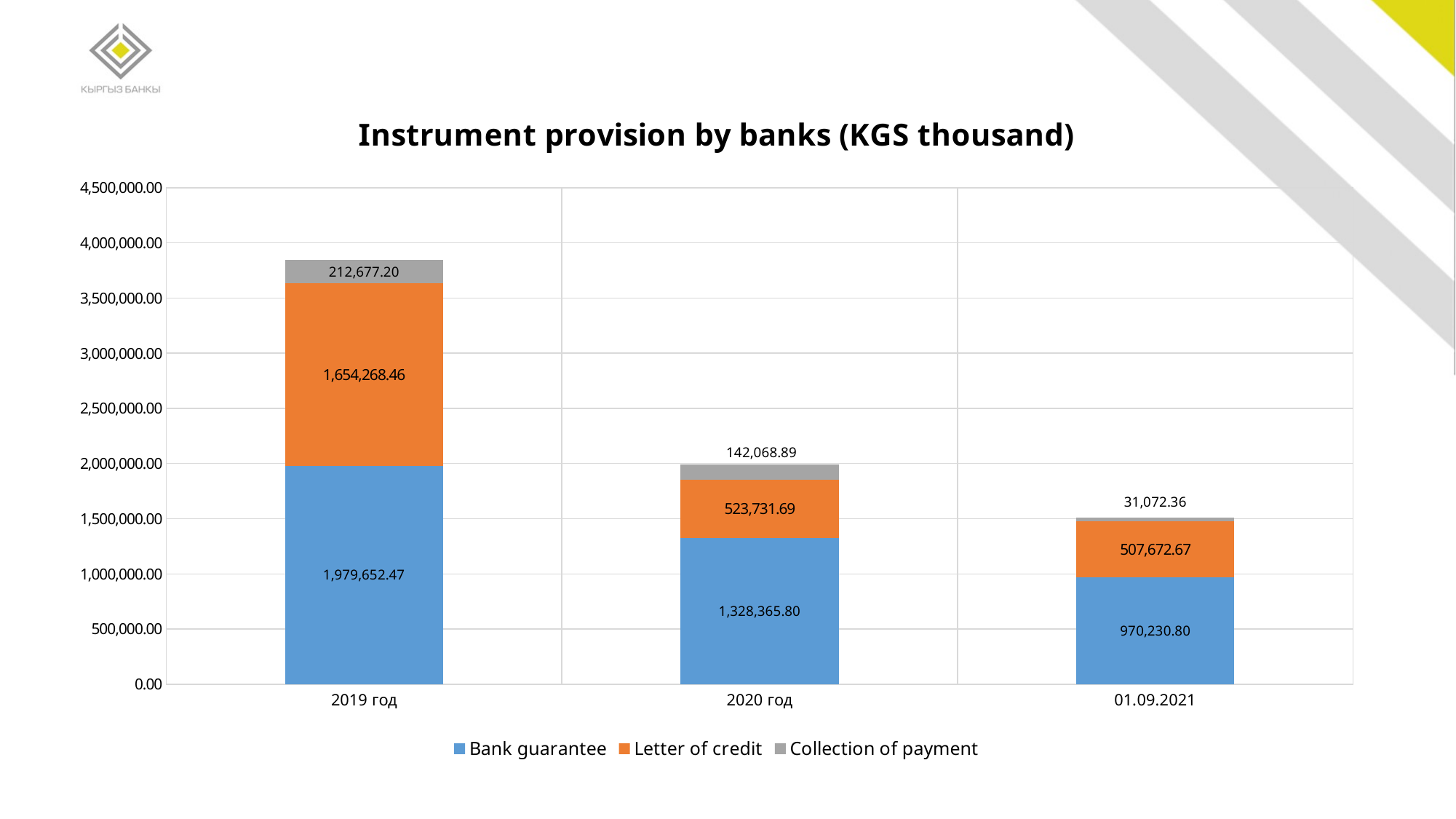
What is the value of Collection of payment for 01.09.2021? 31,072.36 Which period has the highest Bank guarantee value? 2019 год What is the total of the stacked bar for 2019 год? 3,846,598.13 How many series does the legend list? 3 What is the value of Bank guarantee for 2019 год? 1,979,652.47 How many periods are shown on the x axis? 3 What is the difference between the Bank guarantee values for 2019 год and 2020 год? 651,286.67 What is the total of the stacked bar for 01.09.2021? 1,508,975.83 Do the Bank guarantee values rise or fall from 2019 год to 01.09.2021? fall Which is larger: Letter of credit for 2020 год or Letter of credit for 01.09.2021? 2020 год What is the value of Letter of credit for 2020 год? 523,731.69 Which period has the lowest Collection of payment value? 01.09.2021